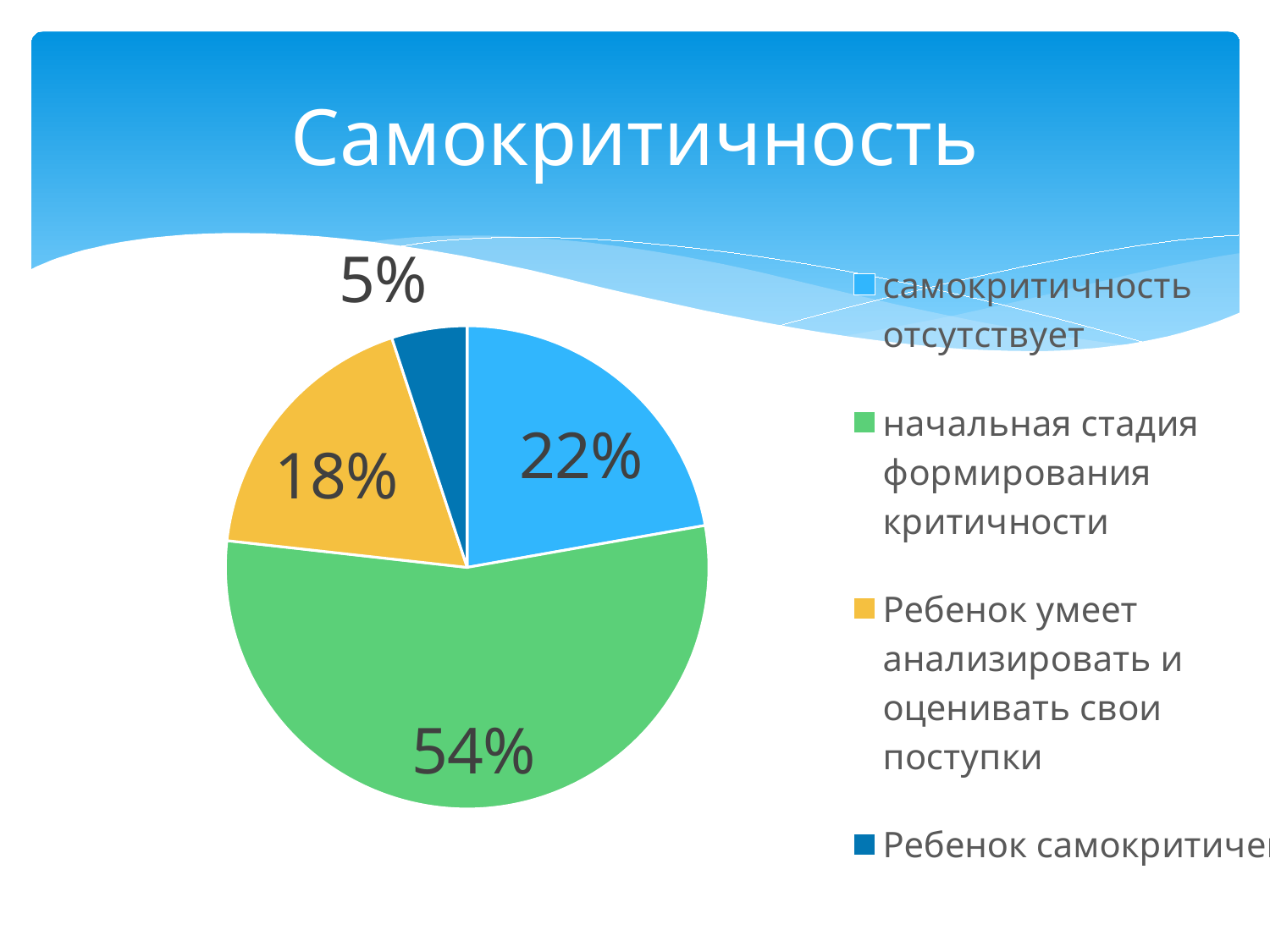
How many entries does the legend list? 4 What share of the pie is 'самокритичность отсутствует'? 22% What share of the pie is 'начальная стадия формирования критичности'? 54% What share of the pie is 'Ребенок умеет анализировать и оценивать свои поступки'? 18% Which is larger: the share for 'самокритичность отсутствует' or for 'Ребенок умеет анализировать и оценивать свои поступки'? самокритичность отсутствует What is the title of the chart? Самокритичность Which slice has the smallest share of the pie? the dark blue slice (5%) What kind of chart is shown on the slide? pie chart How many slices does the pie chart have? 4 Which category has the largest share of the pie? начальная стадия формирования критичности What is the difference between the shares of 'начальная стадия формирования критичности' and 'самокритичность отсутствует'? 32% What percentage is shown for the dark blue slice? 5%